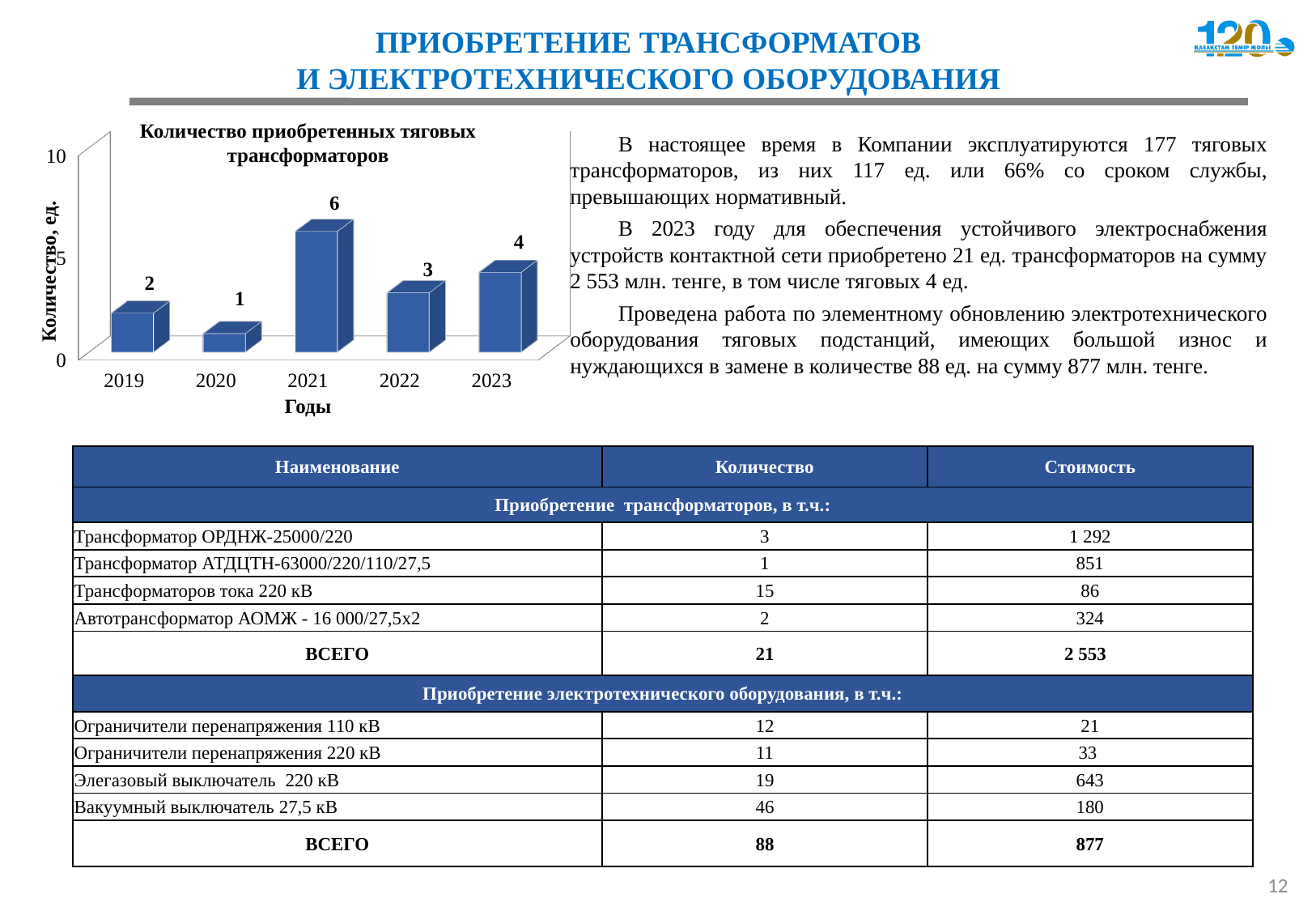
What kind of chart is shown on the slide? bar chart Which year has the lowest value in the chart? 2020 How many years are shown on the x axis of the chart? 5 What is the value for 2019 in the chart? 2 What is the value for 2021 in the chart 'Количество приобретенных тяговых трансформаторов'? 6 What is the value for 2023 in the chart? 4 Do the values rise or fall from 2020 to 2021? rise What is the title of the chart? Количество приобретенных тяговых трансформаторов What is the difference between the values for 2021 and 2022? 3 Which year has the highest value in the chart? 2021 Which is larger, the value for 2019 or the value for 2022? 2022 Is the value for 2021 greater or less than 5? greater